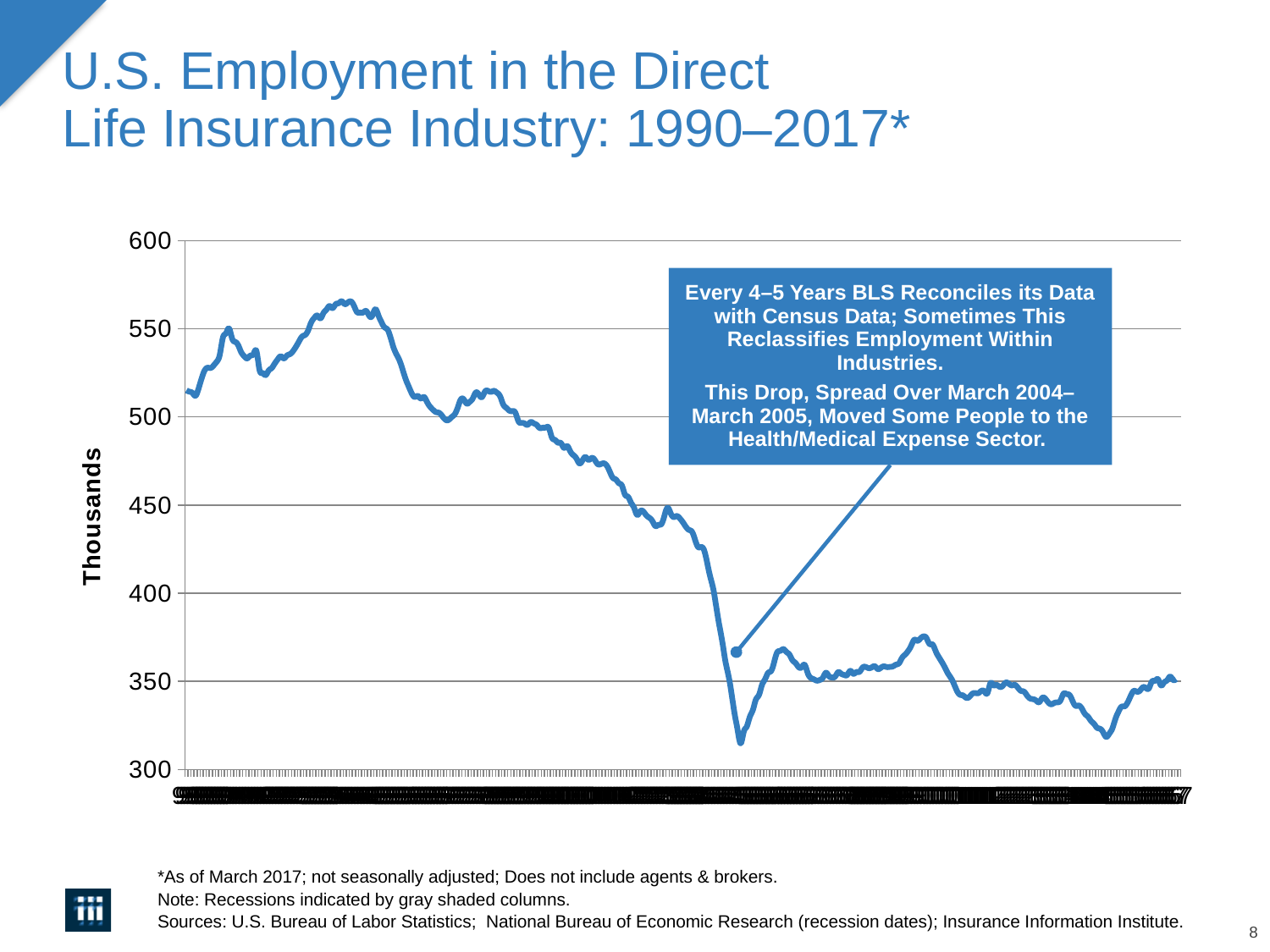
Is the value at the leftmost point of the line greater or less than 500? greater Is the highest point on the line greater or less than 600? less Is the value at the rightmost point of the line greater or less than 400? less Is the value at the leftmost point of the line larger or smaller than the value at the rightmost point? larger What is the label on the vertical axis of the chart? Thousands What kind of chart is shown on the slide? line chart What is the title of the chart on the slide? U.S. Employment in the Direct Life Insurance Industry: 1990–2017* Overall, do the values on the line rise or fall from the left of the x axis to the right? fall